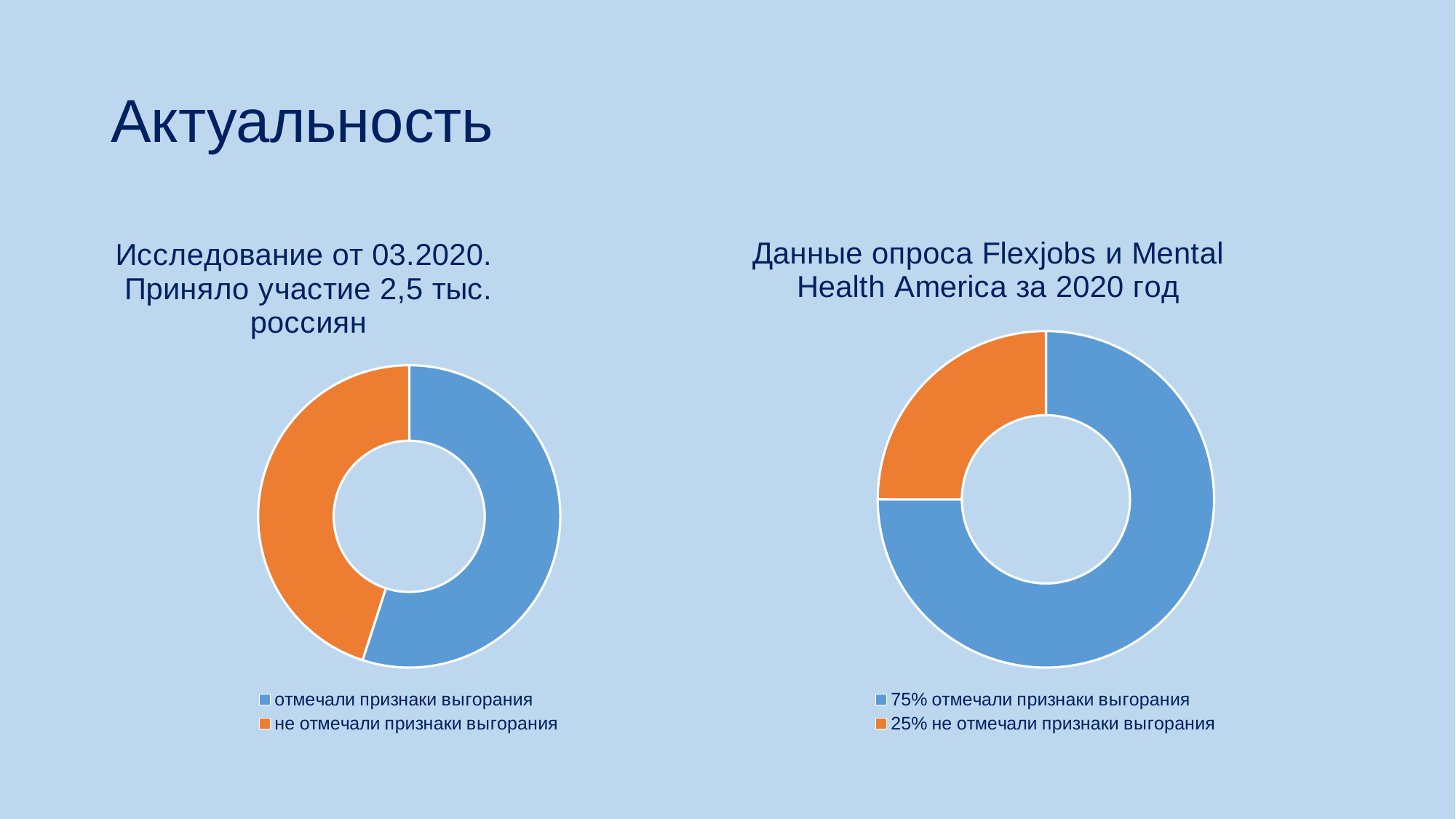
In the right chart (Данные опроса Flexjobs и Mental Health America за 2020 год), what is the difference in percentage points between those who отмечали and those who не отмечали признаки выгорания? 50 percentage points How many categories does the right chart (Данные опроса Flexjobs и Mental Health America за 2020 год) show? 2 How many categories does the left chart (Исследование от 03.2020) show? 2 In the right chart (Данные опроса Flexjobs и Mental Health America за 2020 год), what colour represents "25% не отмечали признаки выгорания"? orange What is the title of the right chart on the slide? Данные опроса Flexjobs и Mental Health America за 2020 год In the right chart (Данные опроса Flexjobs и Mental Health America за 2020 год), which category has the smallest share? 25% не отмечали признаки выгорания In the left chart (Исследование от 03.2020), which slice is larger: "отмечали признаки выгорания" or "не отмечали признаки выгорания"? отмечали признаки выгорания In the right chart (Данные опроса Flexjobs и Mental Health America за 2020 год), what share of respondents не отмечали признаки выгорания? 25% In the right chart (Данные опроса Flexjobs и Mental Health America за 2020 год), which category has the largest share? 75% отмечали признаки выгорания In the left chart (Исследование от 03.2020), which category has the largest slice? отмечали признаки выгорания In the right chart (Данные опроса Flexjobs и Mental Health America за 2020 год), what share of respondents отмечали признаки выгорания? 75% What kind of chart is the left chart titled "Исследование от 03.2020. Приняло участие 2,5 тыс. россиян"? doughnut chart